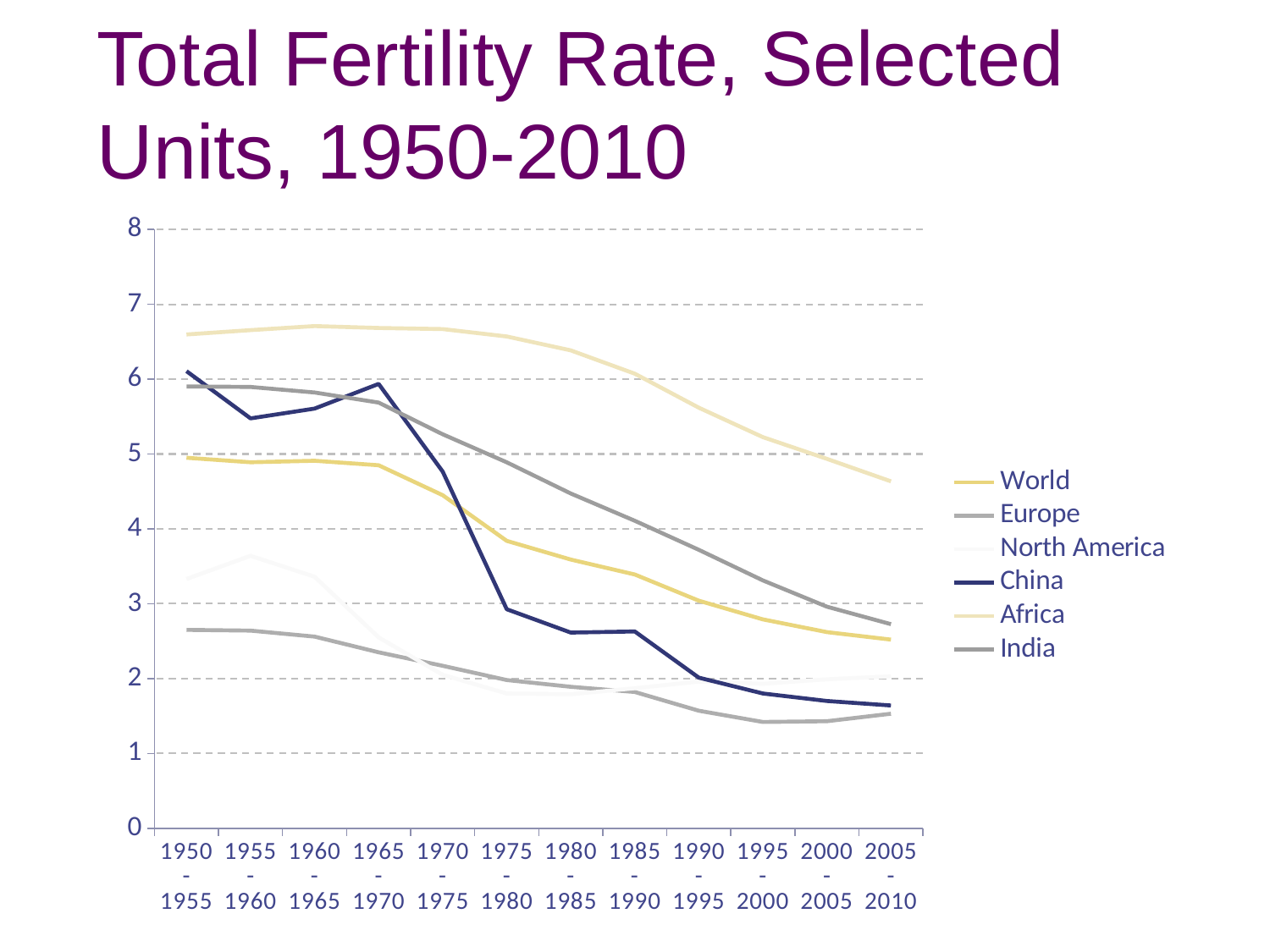
Does the China line rise or fall overall from 1950-1955 to 2005-2010? Fall What colour is the China line in the legend? Dark blue What kind of chart is shown on the slide? Line chart How many time periods are shown along the x axis? 12 How many series does the legend list? 6 In the 1970-1975 period, which is higher, India or Europe? India Which series has the lowest value in the 1995-2000 period? Europe Is the value for Africa in 1950-1955 greater or less than 6? greater In the 1985-1990 period, which is higher, Africa or World? Africa Is the value for World in 2005-2010 greater or less than 3? less Which series has the highest value in the 2005-2010 period? Africa Is the value for China in 1980-1985 greater or less than 3? less